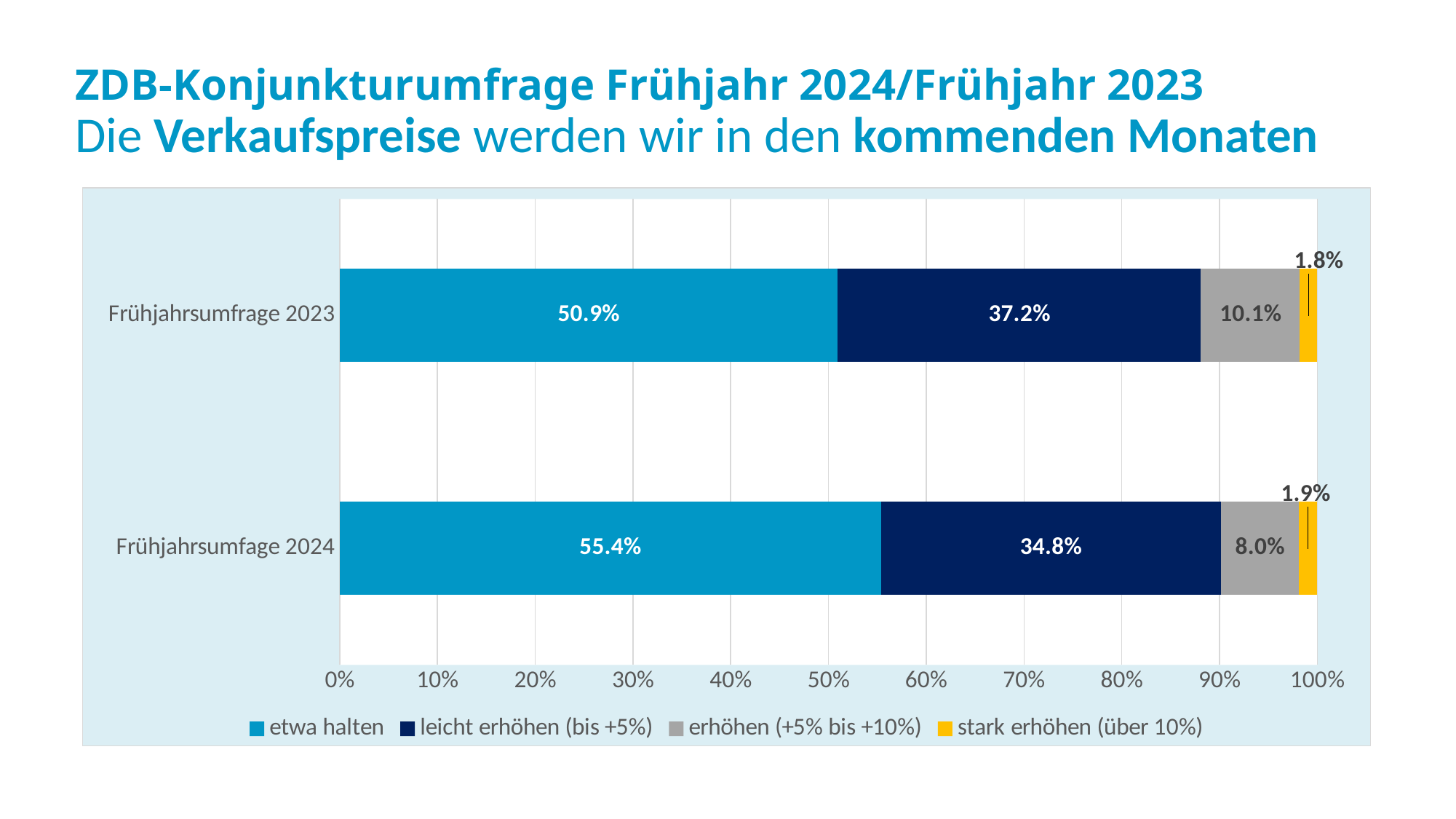
Which survey has the larger "erhöhen (+5% bis +10%)" share, Frühjahrsumfrage 2023 or Frühjahrsumfage 2024? Frühjahrsumfrage 2023 How many bars (categories) are shown in the chart? 2 Which segment is the largest in the Frühjahrsumfage 2024 bar? etwa halten How many series does the legend list? 4 What percentage of respondents in the Frühjahrsumfrage 2023 bar chose "etwa halten"? 50.9% What type of chart is shown on the slide? Stacked bar chart What is the value of the "stark erhöhen (über 10%)" segment for Frühjahrsumfage 2024? 1.9% Which segment is the smallest in the Frühjahrsumfrage 2023 bar? stark erhöhen (über 10%) What is the value of the "erhöhen (+5% bis +10%)" segment for Frühjahrsumfrage 2023? 10.1% What is the value of the "leicht erhöhen (bis +5%)" segment for Frühjahrsumfage 2024? 34.8% By how many percentage points does the "etwa halten" share in Frühjahrsumfage 2024 exceed that in Frühjahrsumfrage 2023? 4.5 percentage points What is the difference between the "leicht erhöhen (bis +5%)" values for Frühjahrsumfrage 2023 and Frühjahrsumfage 2024? 2.4 percentage points